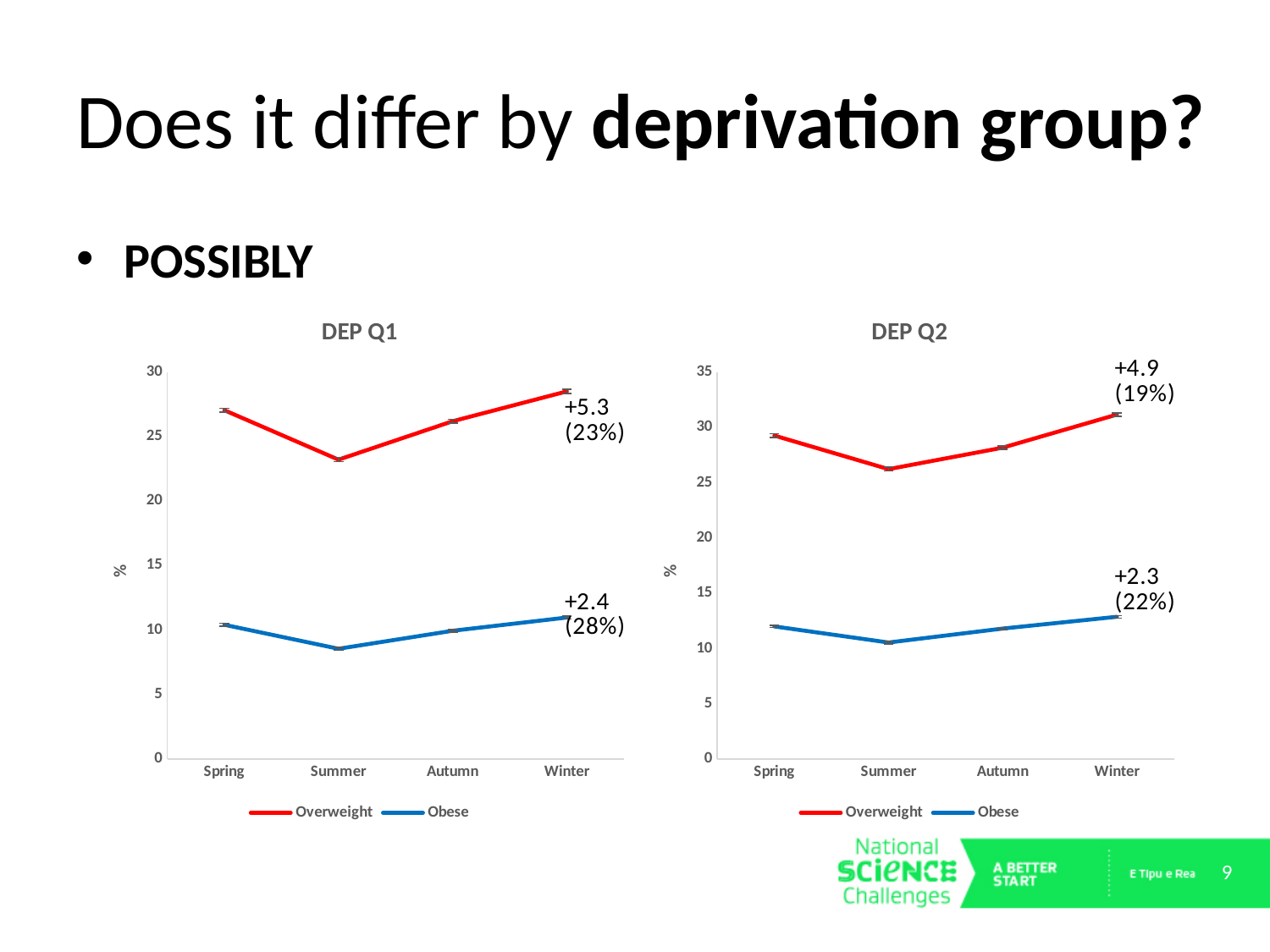
What annotation is printed next to the Winter end of the Overweight line in the DEP Q1 chart? +5.3 (23%) In the DEP Q2 chart, is the Overweight value for Winter greater or less than 30? greater In the DEP Q1 chart, is the Overweight value for Summer greater or less than 20? greater In the DEP Q1 chart, which is larger in Spring, Overweight or Obese? Overweight How many seasons are shown on the x axis of the DEP Q1 chart? 4 What kind of chart is the DEP Q1 chart? line chart In the DEP Q2 chart, does the Obese line rise or fall from Summer to Winter? rise In the DEP Q2 chart, in which season is the Overweight line highest? Winter How many series does the legend of the DEP Q2 chart list? 2 What colour is the Obese line in the DEP Q2 chart? blue In the DEP Q1 chart, in which season is the Overweight line lowest? Summer In the DEP Q2 chart, is the Obese value for Winter greater or less than 15? less